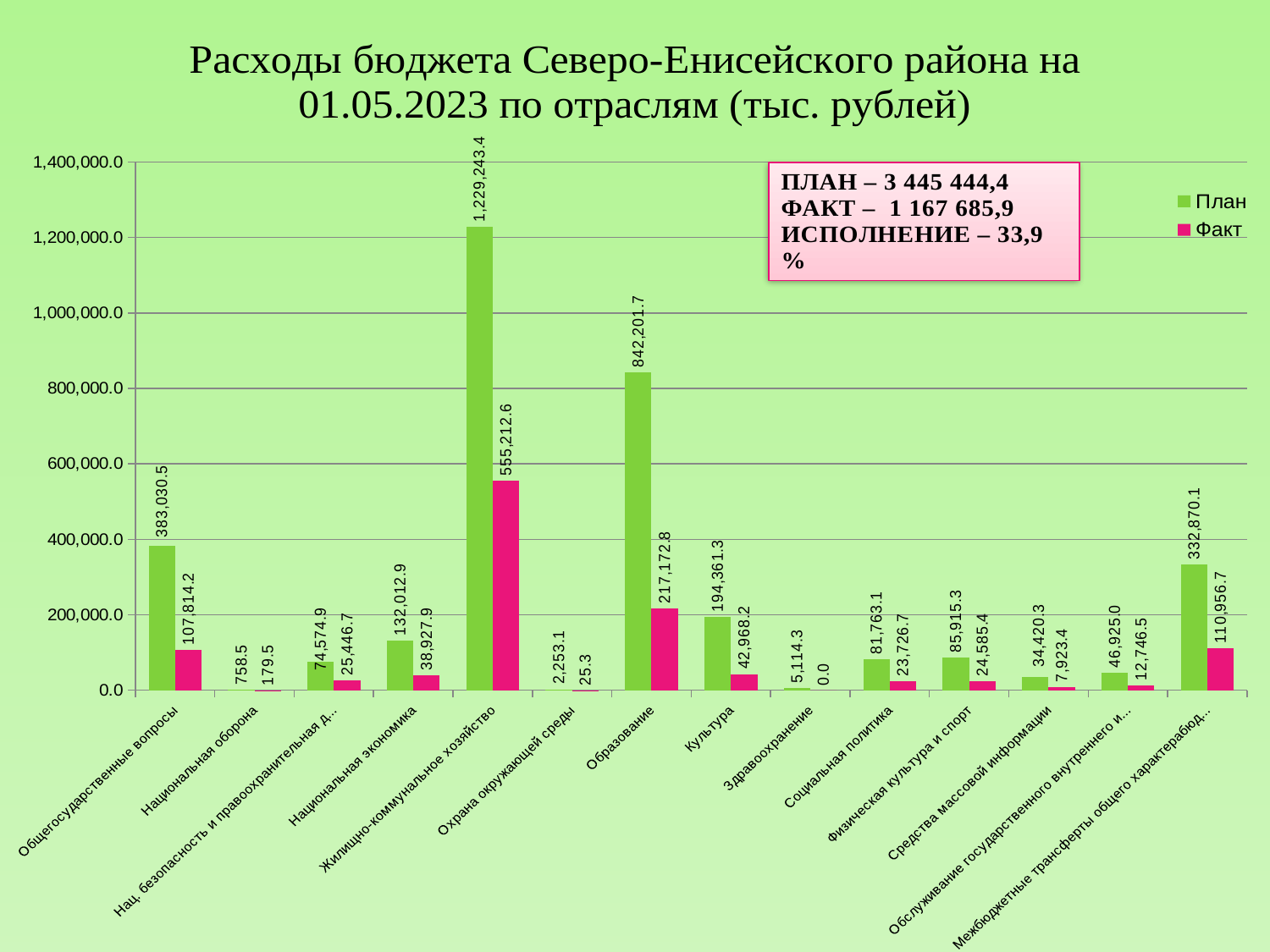
What is the План value for Образование? 842,201.7 How many series does the legend list? 2 What is the Факт value for Жилищно-коммунальное хозяйство? 555,212.6 What kind of chart is shown on the slide? bar chart What is the Факт value for Здравоохранение? 0.0 Is the План value for Образование greater or less than 800,000.0? greater What is the План value for Культура? 194,361.3 What is the difference between the План and Факт values for Образование? 625,028.9 How many categories are shown on the x axis? 14 Which category has the highest План value? Жилищно-коммунальное хозяйство Which is larger: the План value for Общегосударственные вопросы or the План value for Межбюджетные трансферты общего характера? Общегосударственные вопросы Which category has the lowest План value? Национальная оборона